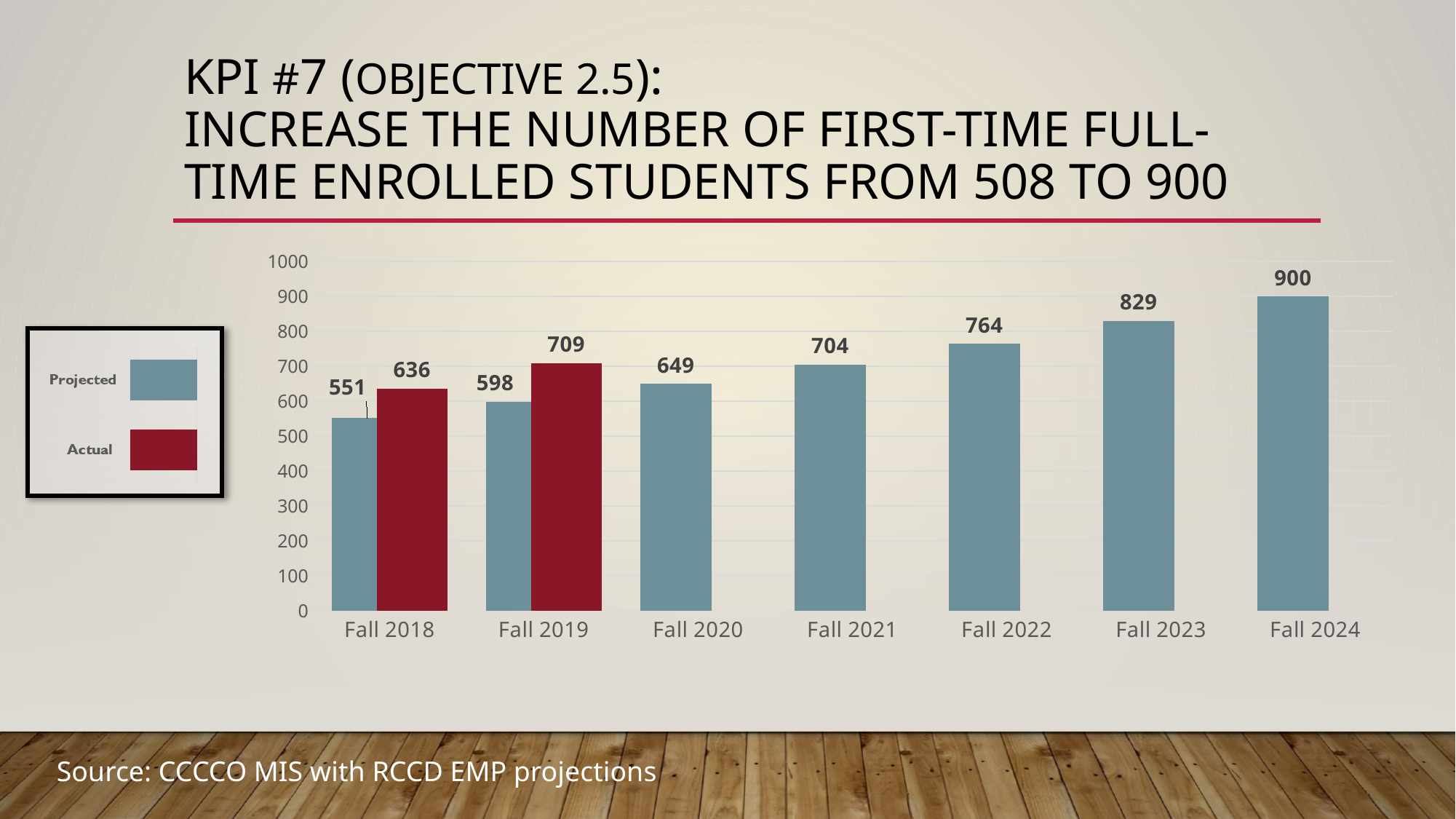
Which year has the highest projected value? Fall 2024 How many years are shown on the x axis? 7 What is the projected value for Fall 2022? 764 What is the difference between the actual and projected values for Fall 2018? 85 Do the projected values rise or fall from Fall 2018 to Fall 2024? Rise What kind of chart is shown on the slide? Bar chart What is the actual value for Fall 2019? 709 Which is larger for Fall 2019, the projected value or the actual value? Actual Which year has the lowest projected value? Fall 2018 How many series does the legend list? 2 What is the projected value for Fall 2018? 551 What is the projected value for Fall 2024? 900